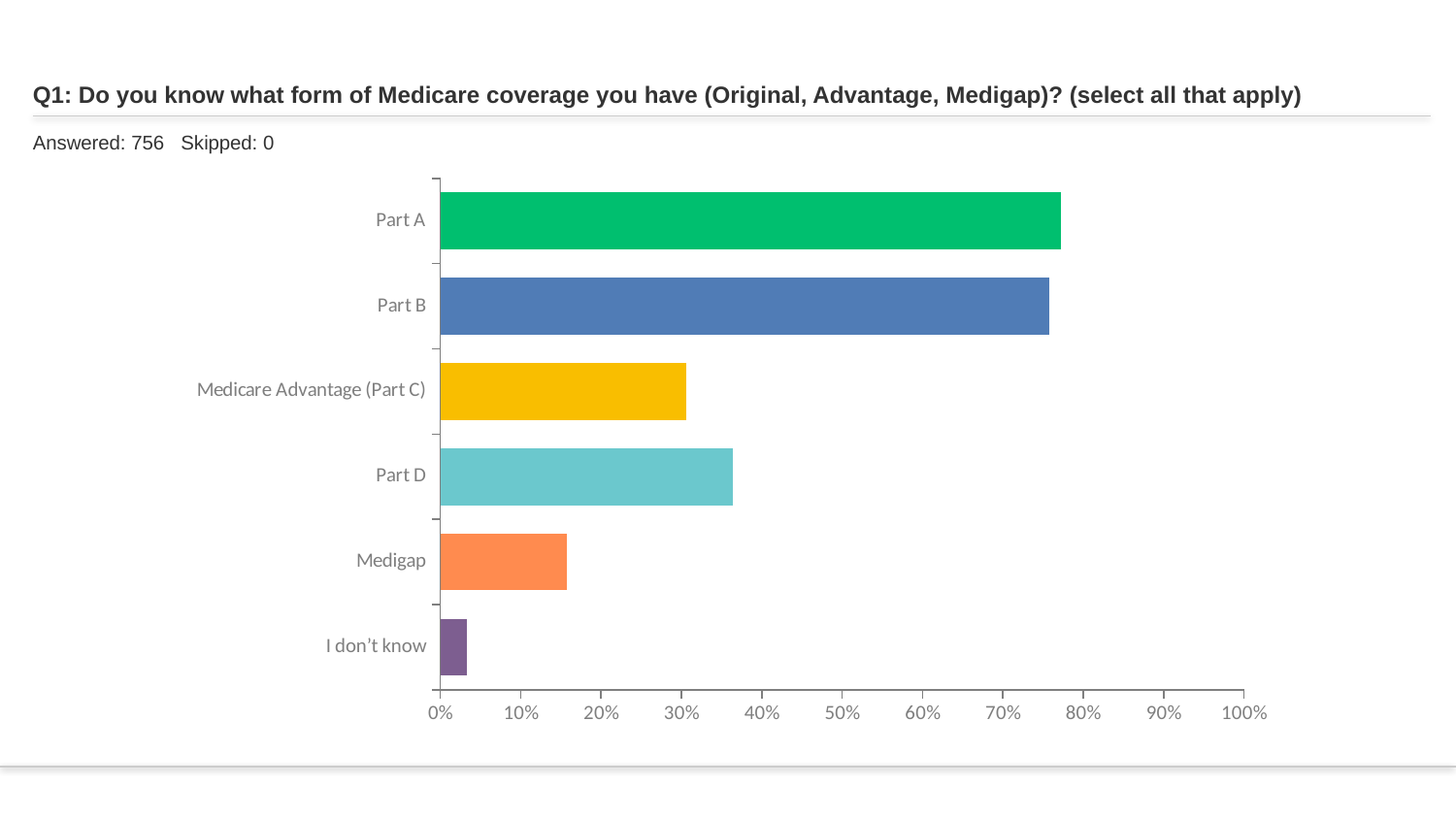
What kind of chart is shown on the slide? bar chart Is the value for I don't know greater or less than 10%? less Which category has the lowest value? I don't know How many respondents answered the question shown on the slide? 756 Is the value for Part D greater or less than 30%? greater Is the value for Part A greater or less than 70%? greater Which is larger, the value for Medigap or the value for Part D? Part D How many categories are shown on the chart? 6 Which is larger, the value for Part D or the value for Medicare Advantage (Part C)? Part D